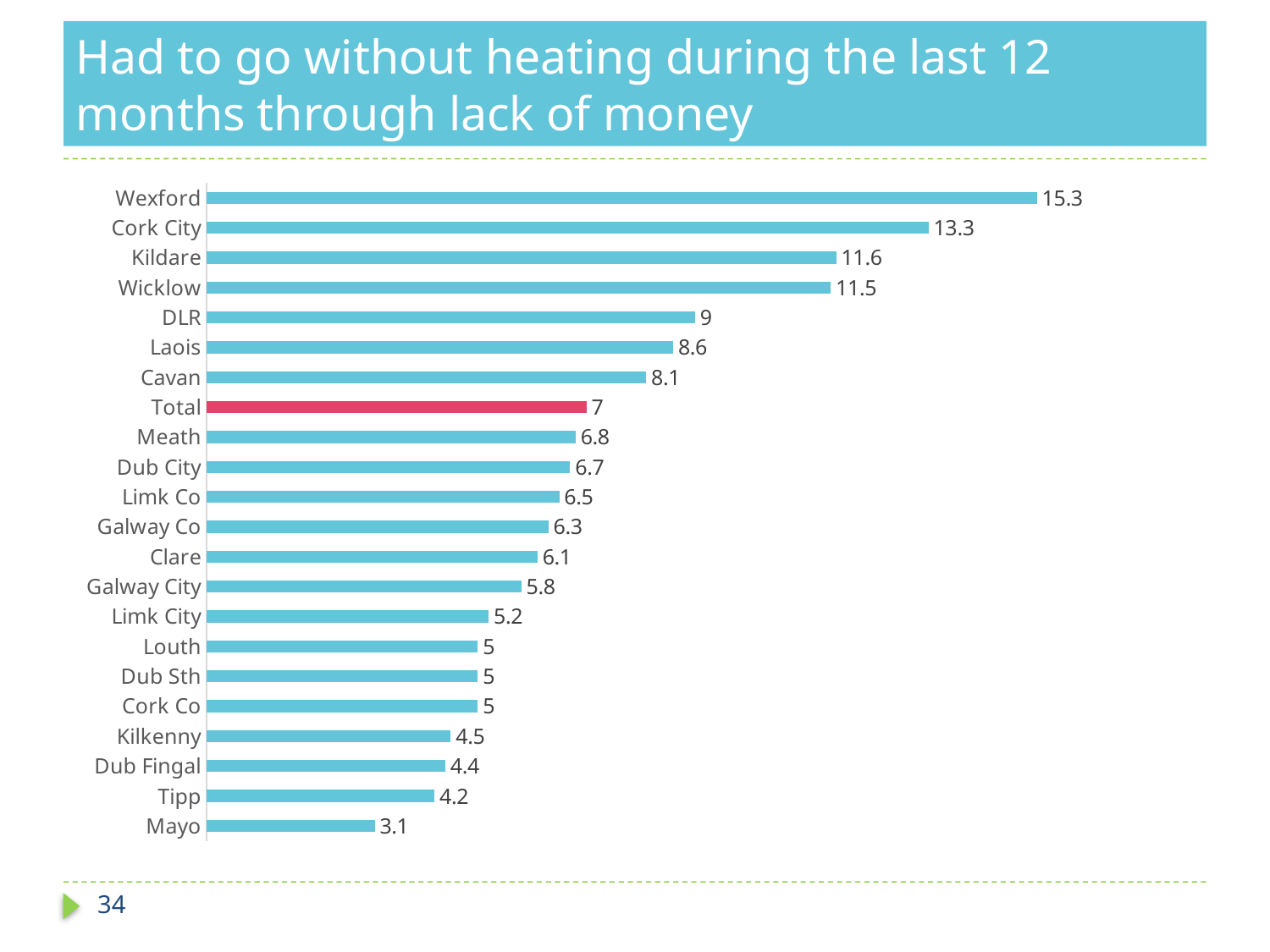
Which is larger, the value for Kildare or the value for DLR? Kildare Which category has the highest value? Wexford What is the difference between the values for Wexford and Cork City? 2 Which bar is shown in a different colour from the others? Total What is the difference between the values for Total and Mayo? 3.9 How many categories are shown in the chart? 22 Which category has the lowest value? Mayo What is the value for Total? 7 Which is larger, the value for Tipp or the value for Kilkenny? Kilkenny What is the value for Wexford? 15.3 What is the value for Galway City? 5.8 What kind of chart is shown on the slide? Bar chart